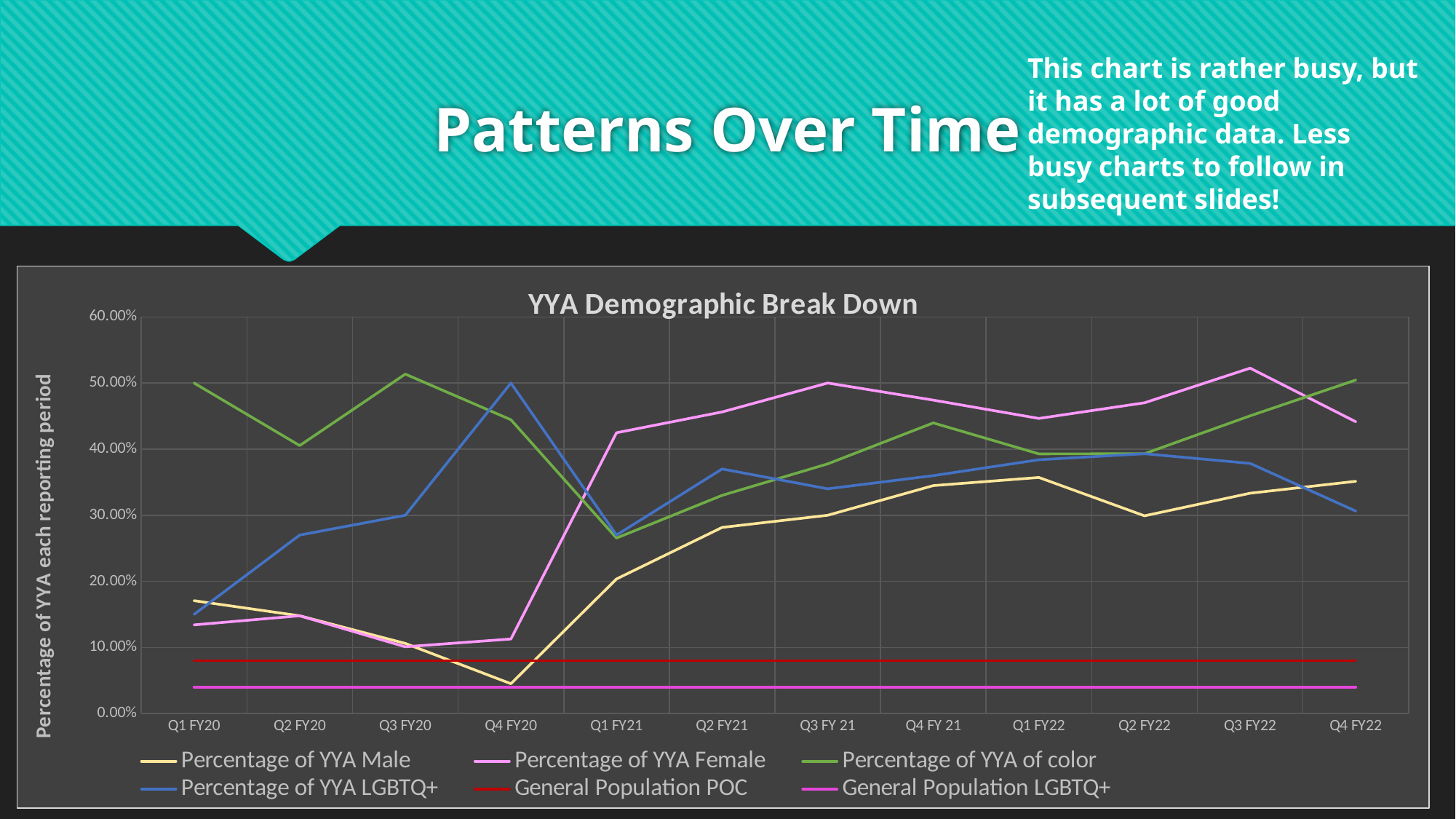
In which reporting period is the Percentage of YYA Male lowest? Q4 FY20 What is the title of the chart? YYA Demographic Break Down What is the label on the vertical axis of the chart? Percentage of YYA each reporting period What kind of chart is shown on the slide? line chart Does the Percentage of YYA Male rise or fall from Q4 FY20 to Q1 FY22? rise In which reporting period is the Percentage of YYA LGBTQ+ highest? Q4 FY20 Is the value for Percentage of YYA LGBTQ+ at Q4 FY20 greater or less than 40.00%? greater Is the General Population POC line greater or less than 10.00%? less Is the value for Percentage of YYA Male at Q4 FY20 greater or less than 10.00%? less At Q4 FY22, which is higher: Percentage of YYA of color or Percentage of YYA Female? Percentage of YYA of color How many series does the legend of the chart list? 6 How many reporting periods are shown along the x axis of the chart? 12